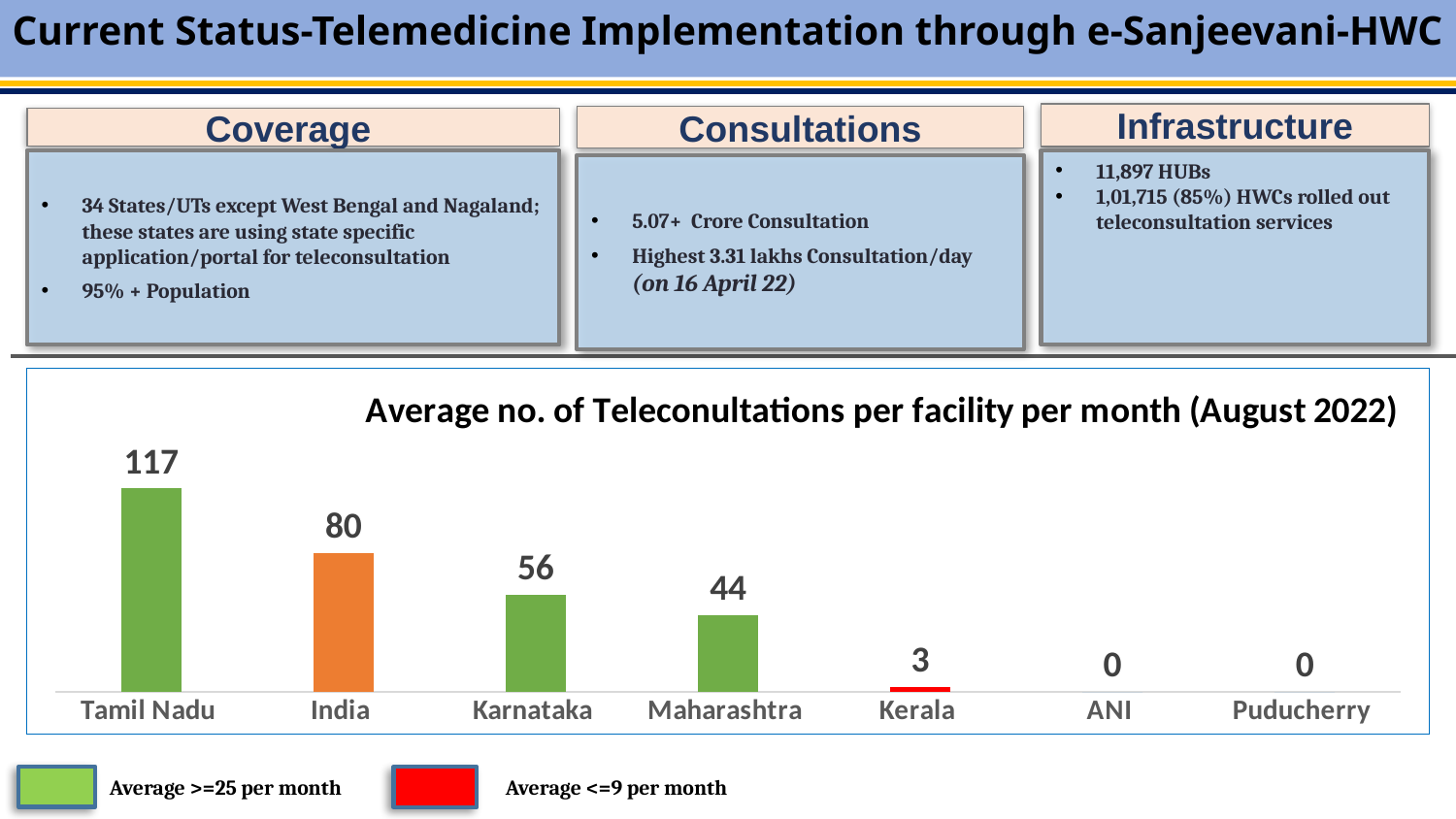
How many categories are shown on the x axis of the chart? 7 What is the value shown for India in the chart? 80 What is the difference between the values for Karnataka and Maharashtra? 12 What is the average number of teleconsultations per facility per month for Tamil Nadu? 117 Which has a larger value, Karnataka or Maharashtra? Karnataka What type of chart is shown on the slide? Bar chart What is the title of the chart? Average no. of Teleconultations per facility per month (August 2022) Which category has the highest average number of teleconsultations per facility per month? Tamil Nadu What is the value shown for Kerala? 3 What is the difference between the values for Tamil Nadu and India? 37 Which categories show a value of 0 in the chart? ANI and Puducherry What is the value shown for Karnataka? 56